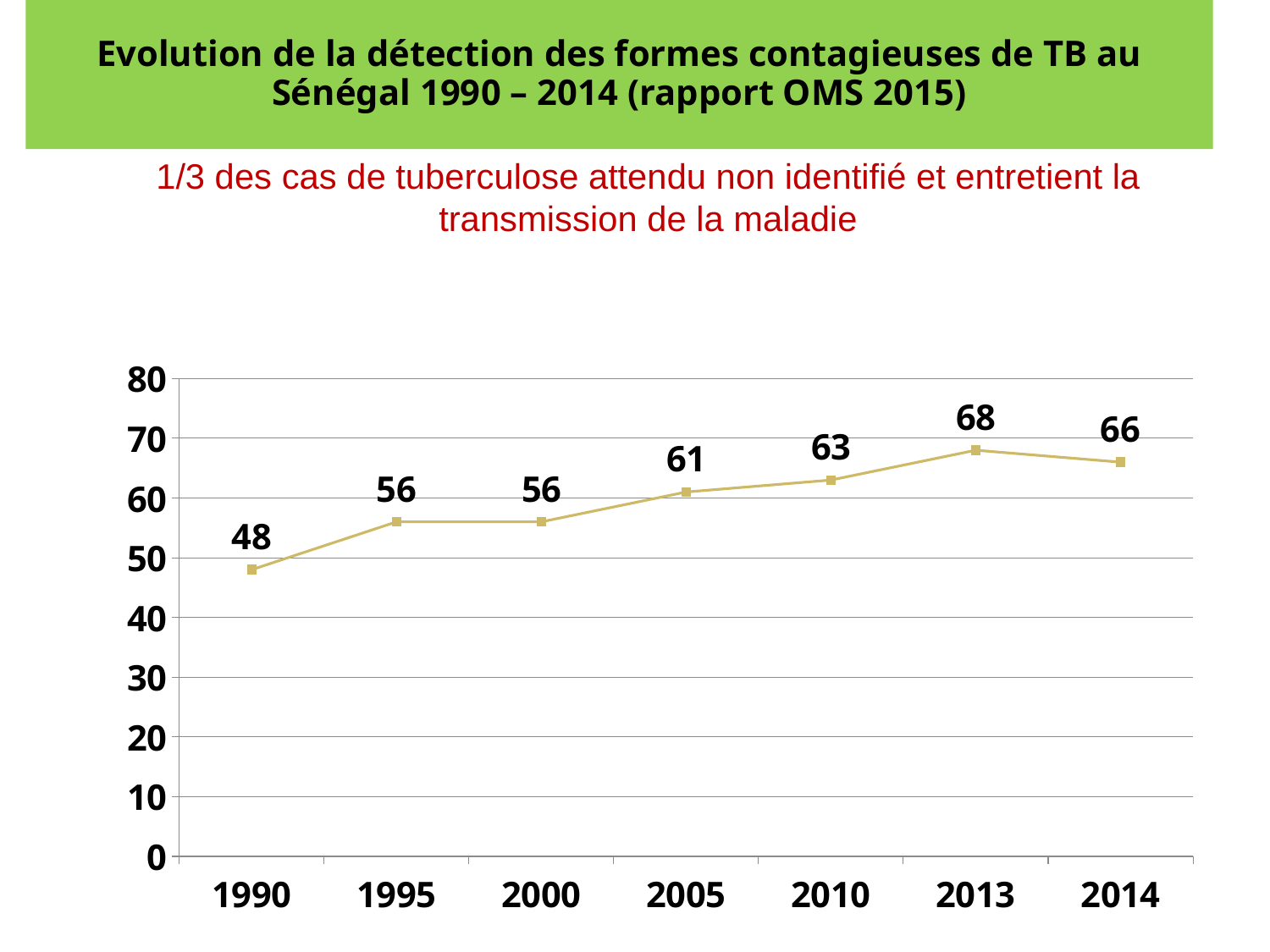
Is the value for 1990 greater or less than 50? less What is the value for 2014? 66 Do the values generally rise or fall from 1990 to 2013? rise Which year has the highest value? 2013 What is the value for 1990? 48 What is the difference between the values for 2013 and 1990? 20 What is the difference between the values for 2010 and 2005? 2 Which is larger, the value for 2013 or the value for 2014? 2013 Which year has the lowest value? 1990 What is the value for 2005? 61 How many years are plotted on the chart? 7 What kind of chart is shown on the slide? line chart